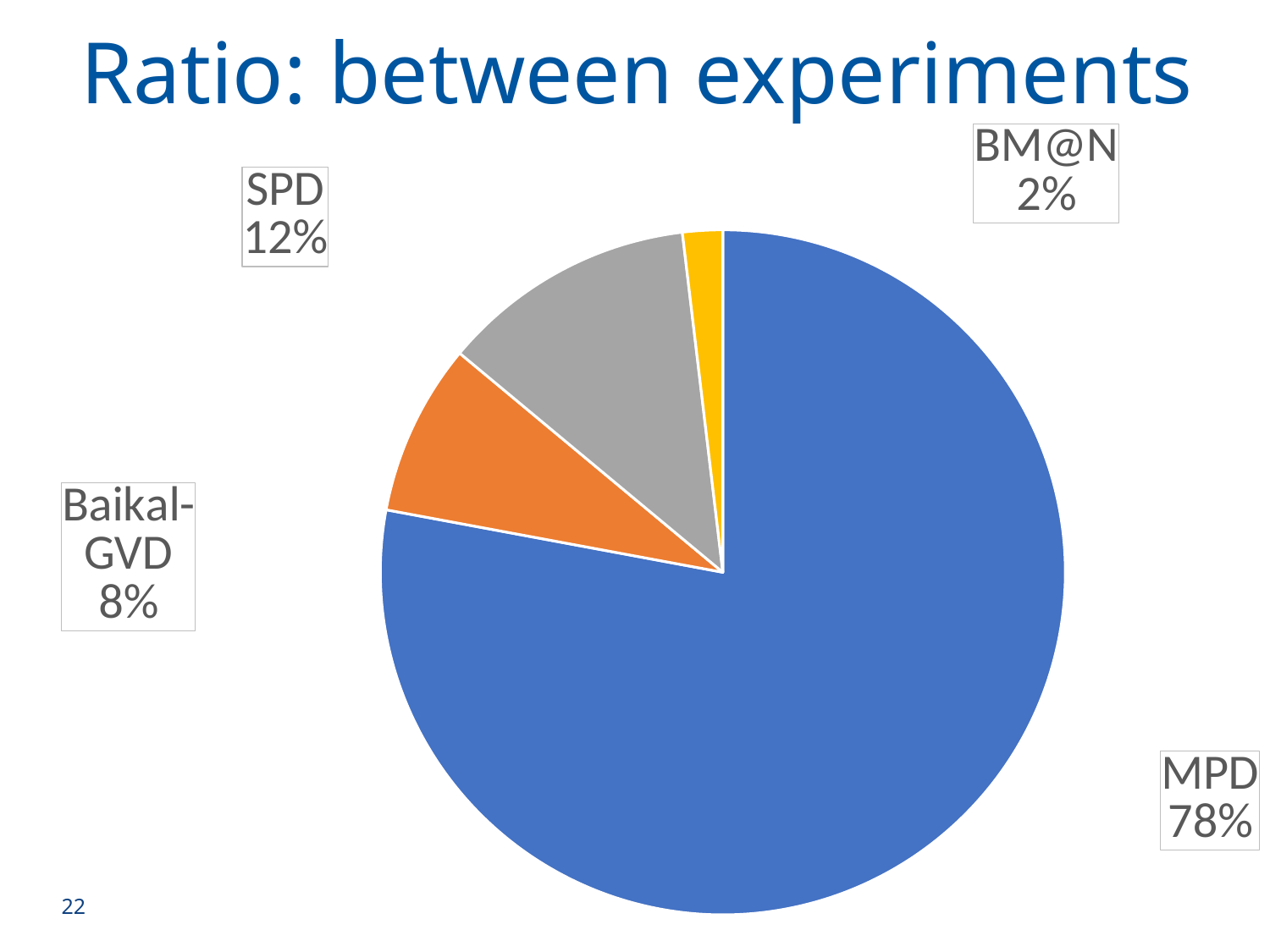
Which is larger, the share for SPD or the share for Baikal-GVD? SPD What colour is the MPD slice? blue What is the difference in percentage points between SPD and Baikal-GVD? 4 What is the share for SPD? 12% What kind of chart is shown on the slide? pie chart Which experiment has the smallest share of the pie? BM@N Which experiment has the largest share of the pie? MPD What is the title of the chart? Ratio: between experiments What is the share for MPD? 78% What is the share for Baikal-GVD? 8% What is the share for BM@N? 2% How many slices does the pie chart have? 4